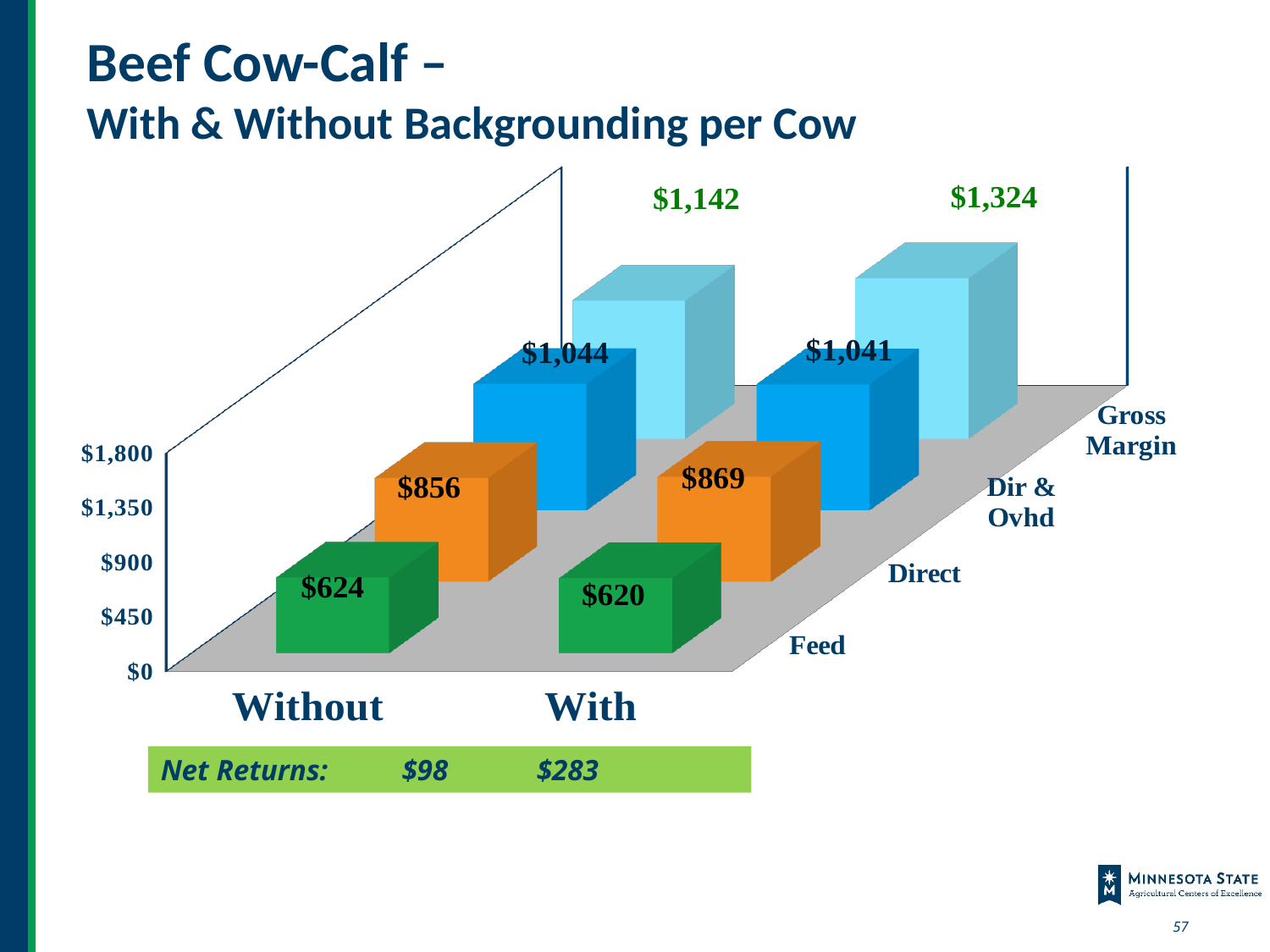
What is the Dir & Ovhd value for Without backgrounding? $1,044 How many scenario categories are shown on the x axis? 2 What is the difference between the Direct values for With and Without? $13 What kind of chart is shown on the slide? Bar chart Which series has the lowest value for the With scenario? Feed Which series has the highest value for the Without scenario? Gross Margin What is the Direct value for With backgrounding? $869 What is the Feed value for Without backgrounding? $624 How many series (Feed, Direct, Dir & Ovhd, Gross Margin) are plotted on the chart? 4 What is the Gross Margin value for With backgrounding? $1,324 Which scenario has the higher Gross Margin, Without or With? With What is the difference between the Gross Margin values for With and Without? $182